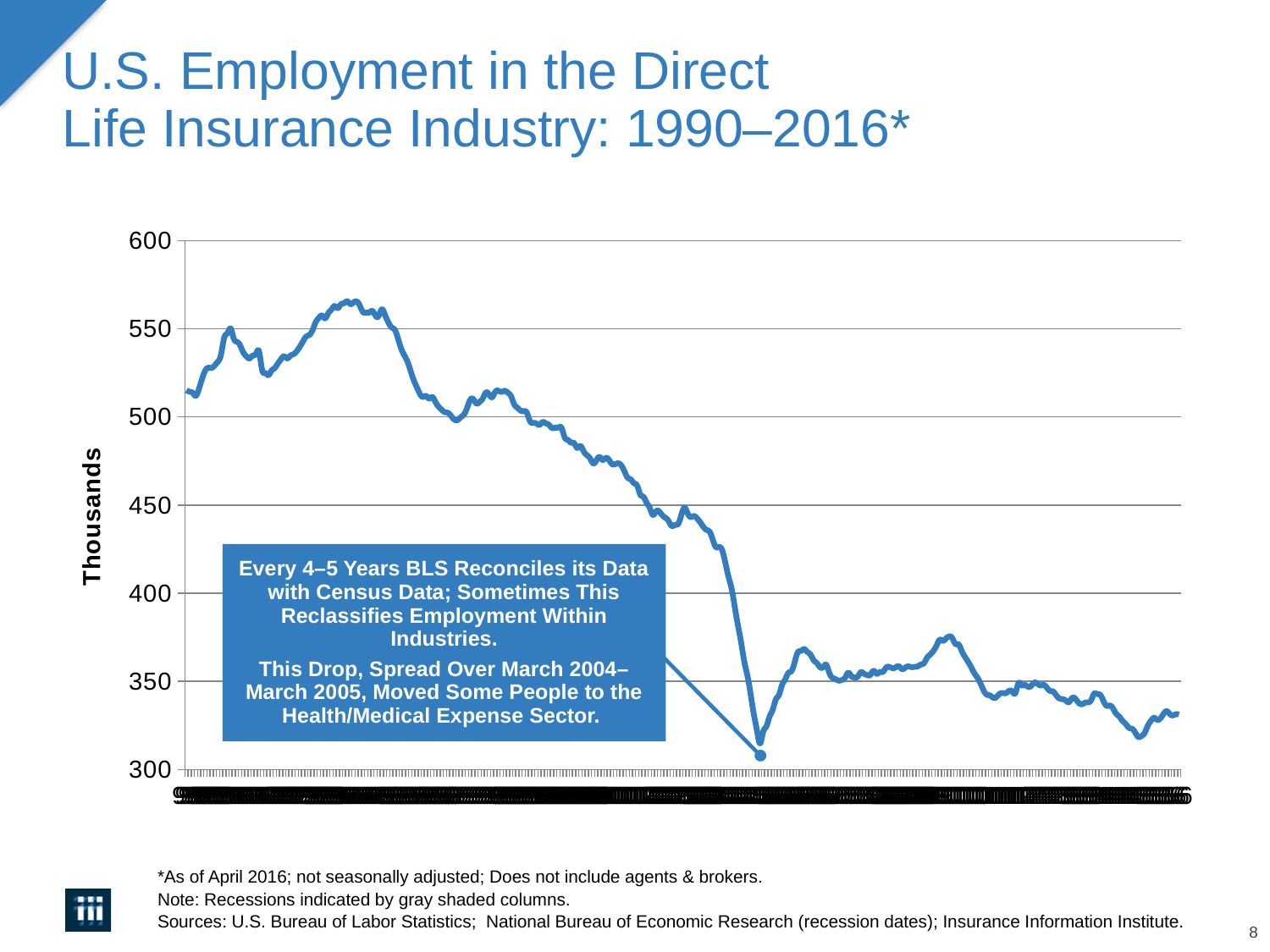
Is the value at the start of the series (left end of the line) greater or less than 500? greater What is the title of the chart on the slide? U.S. Employment in the Direct Life Insurance Industry: 1990–2016* What is the label on the vertical axis of the chart? Thousands Is the value at the end of the series (right end of the line) greater or less than 300? greater What is the lowest value shown on the vertical axis? 300 What is the highest value shown on the vertical axis? 600 Is the highest point on the line greater or less than 550? greater Overall, do the values on the chart rise or fall from the left of the x axis to the right? fall What kind of chart is shown on the slide? line chart